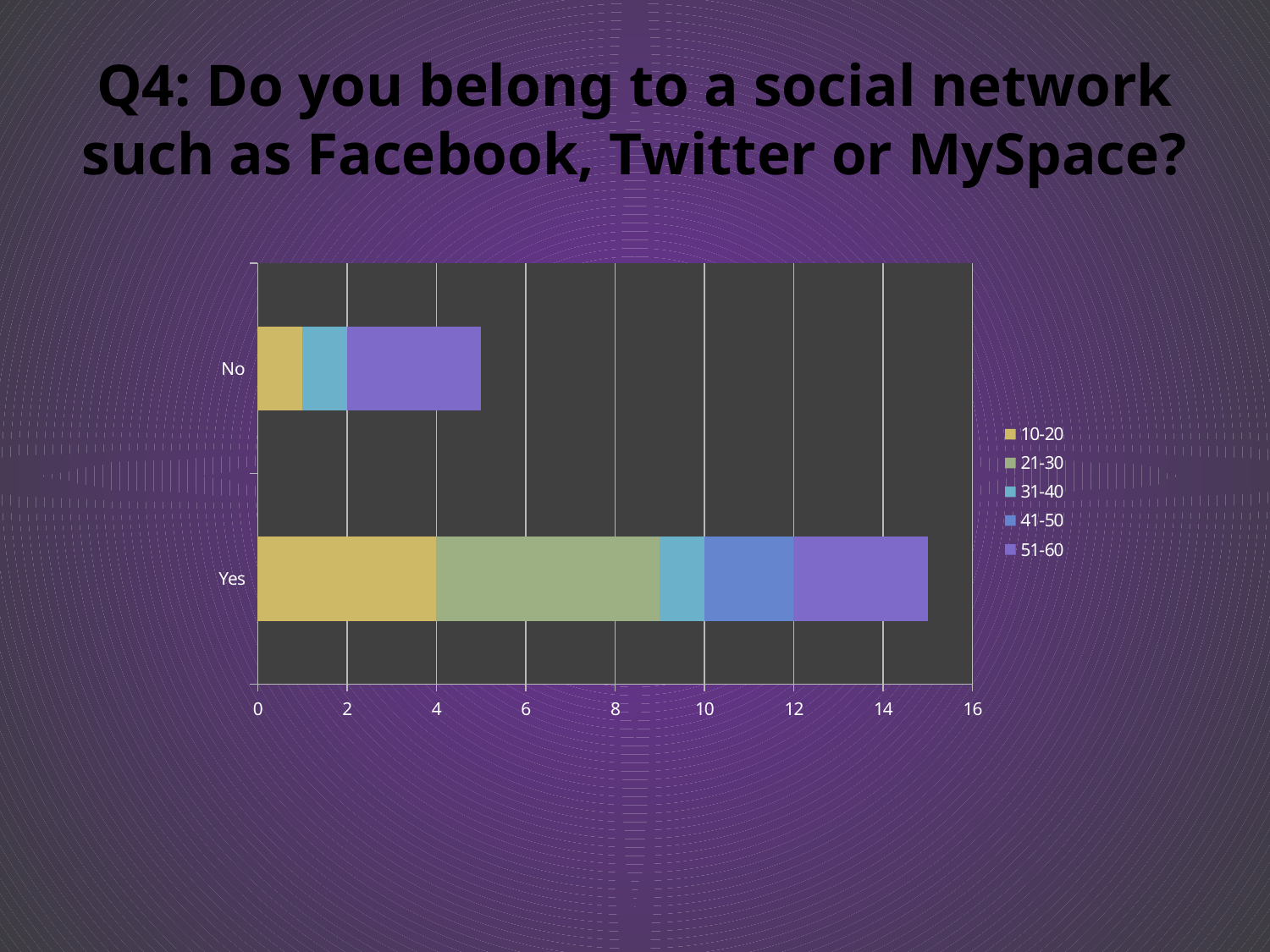
Is the total value for No greater or less than 4? greater How many categories are shown on the vertical axis of the chart? 2 Is the total value for Yes greater or less than 14? greater What is the value of the 10-20 segment for Yes? 4 What is the highest value shown on the horizontal axis? 16 Which category has the shortest total bar? No Which age group is listed first in the legend? 10-20 Which category has the longer total bar, Yes or No? Yes Is the total value for No greater or less than 6? less How many series does the chart's legend list? 5 What kind of chart is shown on the slide? Stacked bar chart